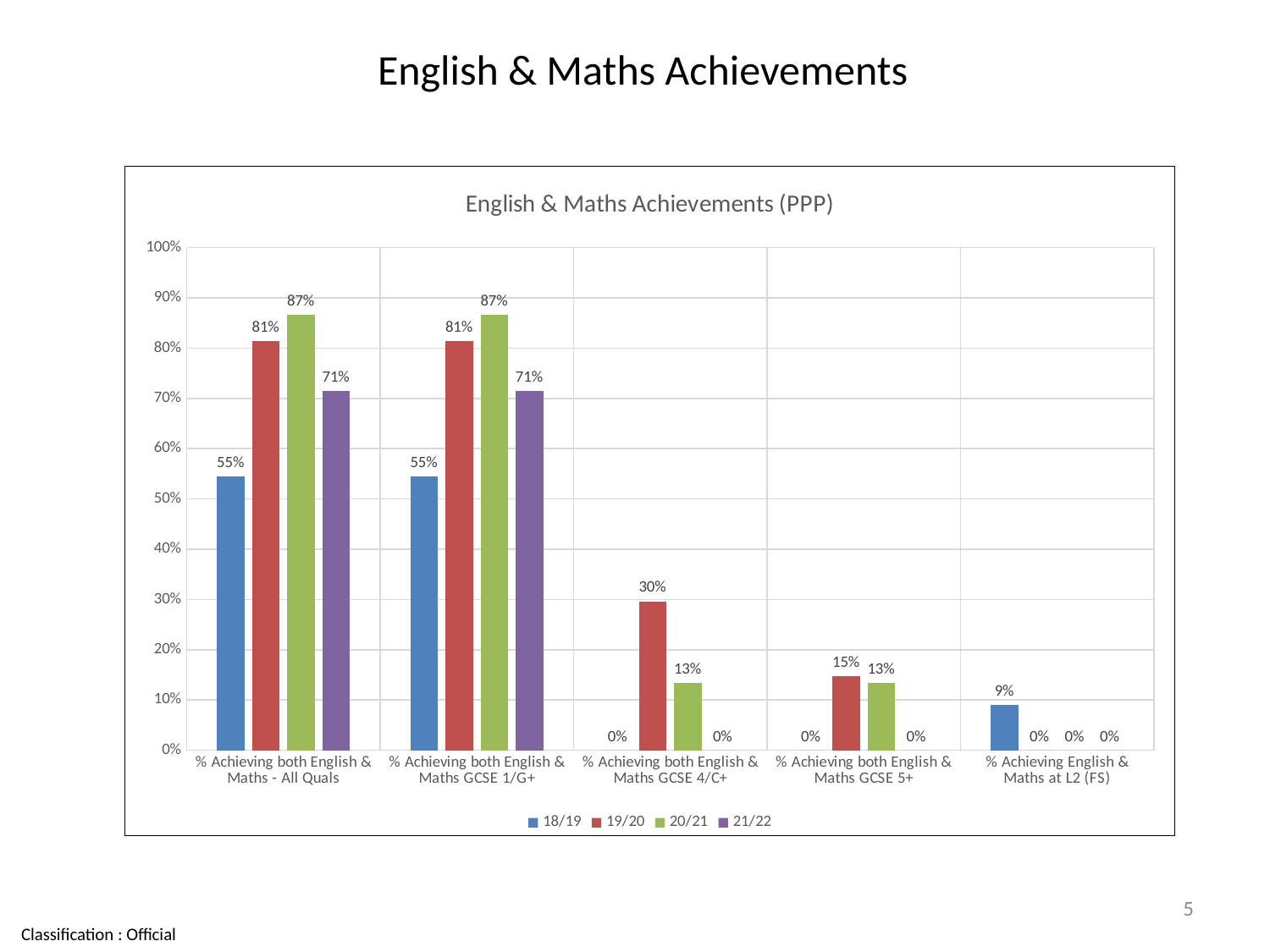
What is the value for 19/20 in the '% Achieving both English & Maths GCSE 4/C+' category? 30% Which series has the lowest value in the '% Achieving both English & Maths GCSE 1/G+' category? 18/19 How many categories are shown on the x axis? 5 What kind of chart is shown on the slide? Bar chart Which series has the highest value in the '% Achieving both English & Maths - All Quals' category? 20/21 Which is larger in the '% Achieving both English & Maths GCSE 5+' category: the 19/20 value or the 20/21 value? 19/20 What is the difference between the 20/21 and 18/19 values in the '% Achieving both English & Maths - All Quals' category? 32% What is the difference between the 19/20 and 20/21 values in the '% Achieving both English & Maths GCSE 4/C+' category? 17% How many series does the legend list? 4 What is the value for 21/22 in the '% Achieving both English & Maths GCSE 1/G+' category? 71% What is the value for 18/19 in the '% Achieving English & Maths at L2 (FS)' category? 9% What is the value for 20/21 in the '% Achieving both English & Maths - All Quals' category? 87%